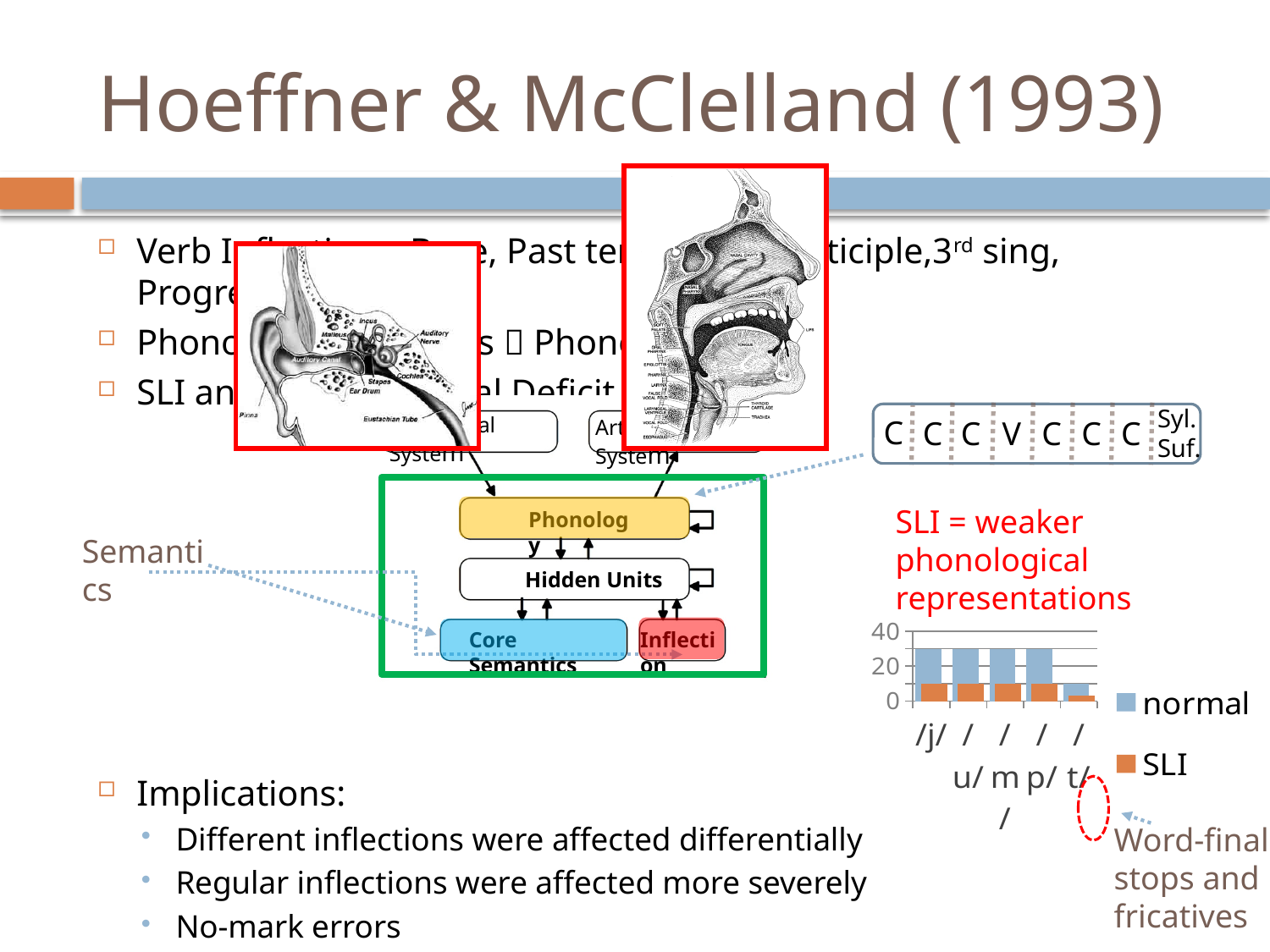
In the bar chart, which series has the taller bars in every category? normal What are the two series named in the legend of the bar chart? normal and SLI In the bar chart, is the value for SLI at /j/ greater or less than 20? less How many series does the legend of the bar chart list? 2 In the bar chart, which category has the lowest normal value? the rightmost category (/t/) What is the highest tick value shown on the y axis of the bar chart? 40 In the bar chart, is the value for normal at /j/ greater or less than 20? greater In the bar chart, which is larger at /j/: the normal value or the SLI value? normal In the bar chart, is the normal value for the rightmost category greater or less than 20? less What colour represents the SLI series in the bar chart? orange What kind of chart is shown at the bottom right of the slide? bar chart How many categories are plotted along the x axis of the bar chart? 5